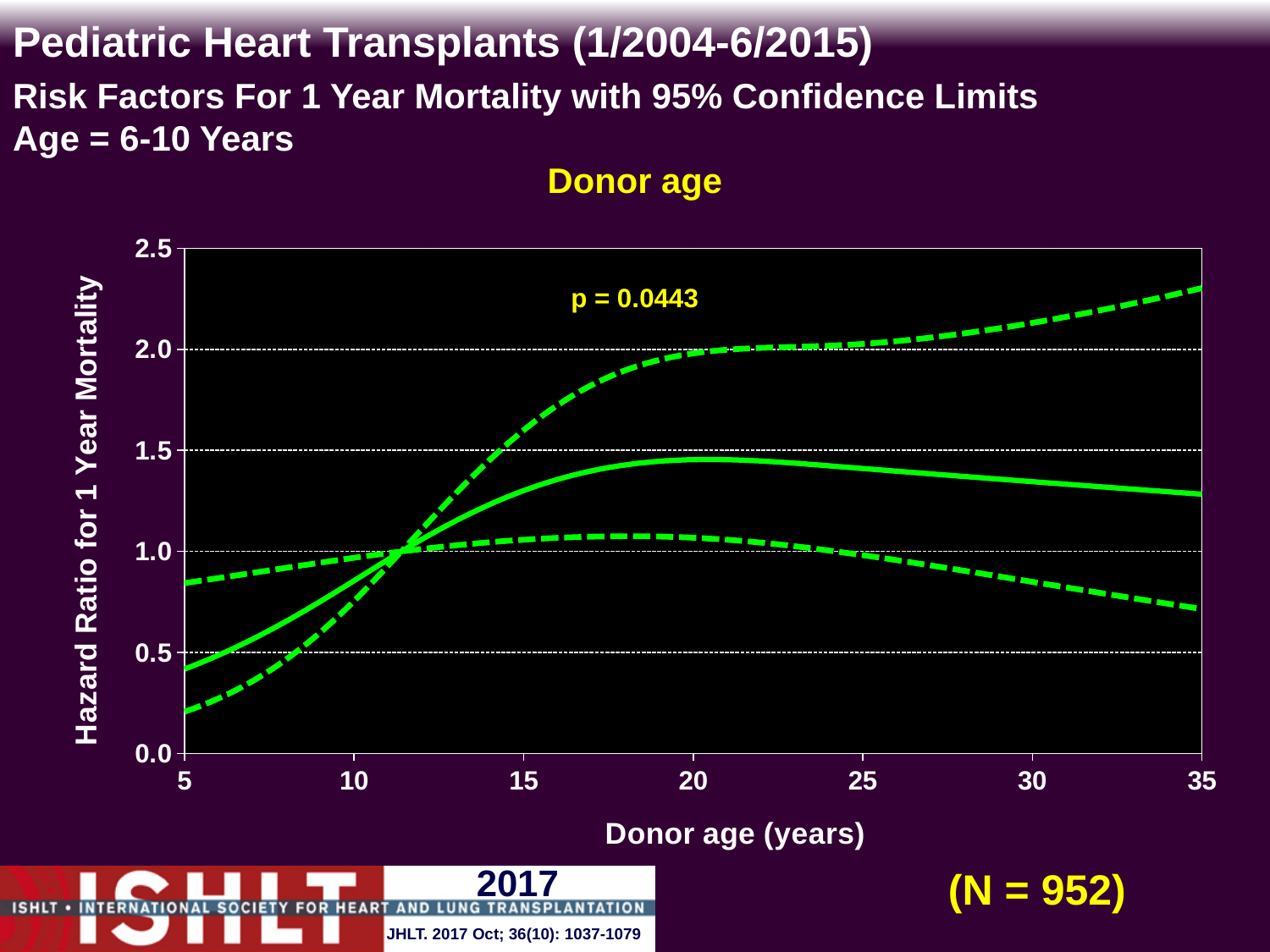
Does the upper dashed confidence limit rise or fall from donor age 5 to donor age 35? rise Is the value of the upper dashed confidence limit at donor age 35 greater or less than 2.0? greater What kind of chart is shown on the slide? line chart Is the value of the lower dashed confidence limit at donor age 35 greater or less than 1.0? less Does the solid hazard ratio line rise or fall between donor age 5 and donor age 20? rise How many lines are plotted on the chart? 3 What is the title shown above the chart? Donor age What p-value is printed on the chart? p = 0.0443 Is the value of the solid hazard ratio line at donor age 20 greater or less than 1.0? greater What is the label of the y axis? Hazard Ratio for 1 Year Mortality What sample size (N) is printed on the slide? N = 952